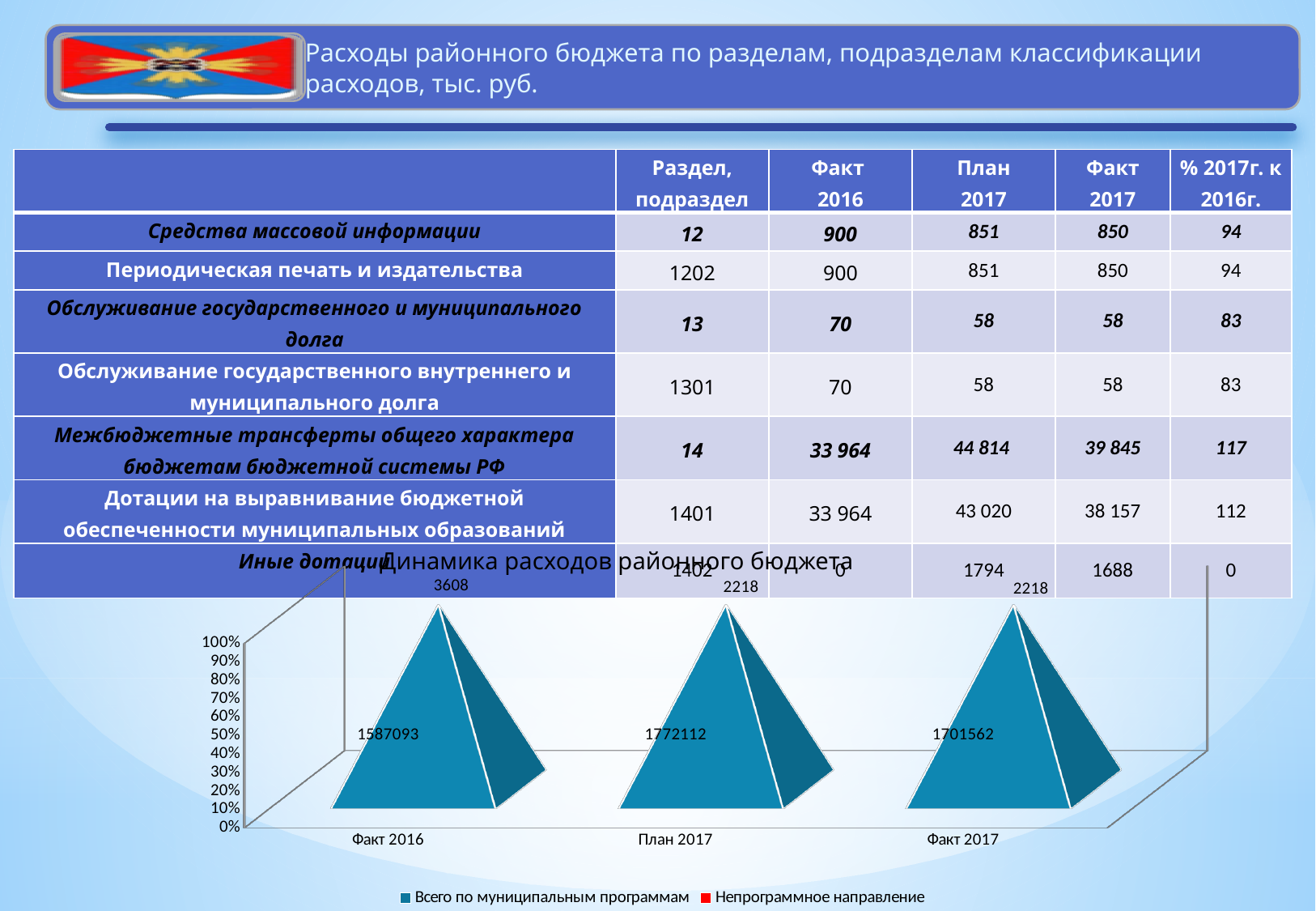
In the chart 'Динамика расходов районного бюджета', what is the value for 'Непрограммное направление' for План 2017? 2218 In the chart 'Динамика расходов районного бюджета', what is the value for 'Всего по муниципальным программам' for План 2017? 1772112 What is the title of the chart on the slide? Динамика расходов районного бюджета In the chart 'Динамика расходов районного бюджета', what is the value for 'Всего по муниципальным программам' for Факт 2016? 1587093 How many series does the legend of the chart 'Динамика расходов районного бюджета' list? 2 In the chart 'Динамика расходов районного бюджета', what is the difference between the 'Всего по муниципальным программам' values for План 2017 and Факт 2016? 185019 In the chart 'Динамика расходов районного бюджета', what is the value for 'Всего по муниципальным программам' for Факт 2017? 1701562 In the chart 'Динамика расходов районного бюджета', which category has the highest value for 'Всего по муниципальным программам'? План 2017 In the chart 'Динамика расходов районного бюджета', which is larger for 'Всего по муниципальным программам': План 2017 or Факт 2017? План 2017 How many categories are shown on the x axis of the chart 'Динамика расходов районного бюджета'? 3 In the chart 'Динамика расходов районного бюджета', what is the value for 'Непрограммное направление' for Факт 2016? 3608 In the chart 'Динамика расходов районного бюджета', which category has the lowest value for 'Всего по муниципальным программам'? Факт 2016